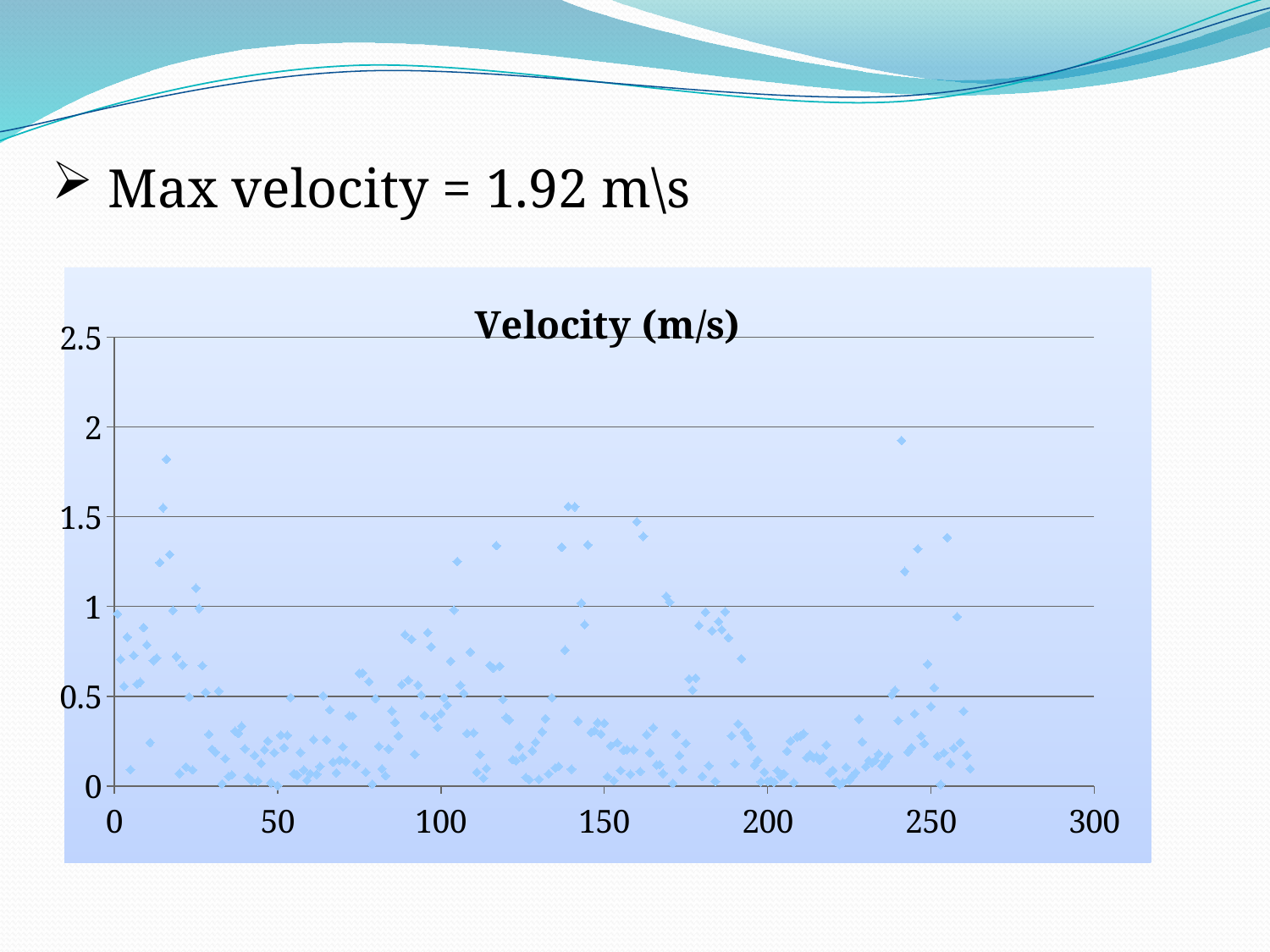
What is the maximum velocity stated on the slide? 1.92 m\s Is the highest point on the chart greater or less than 1.5? greater What kind of chart is shown on the slide? scatter chart What is the highest value shown on the y axis? 2.5 Is the highest point on the chart located before or after x = 200? after Is the highest point on the chart greater or less than 2? less What is the highest value shown on the x axis? 300 What is the title of the chart? Velocity (m/s)